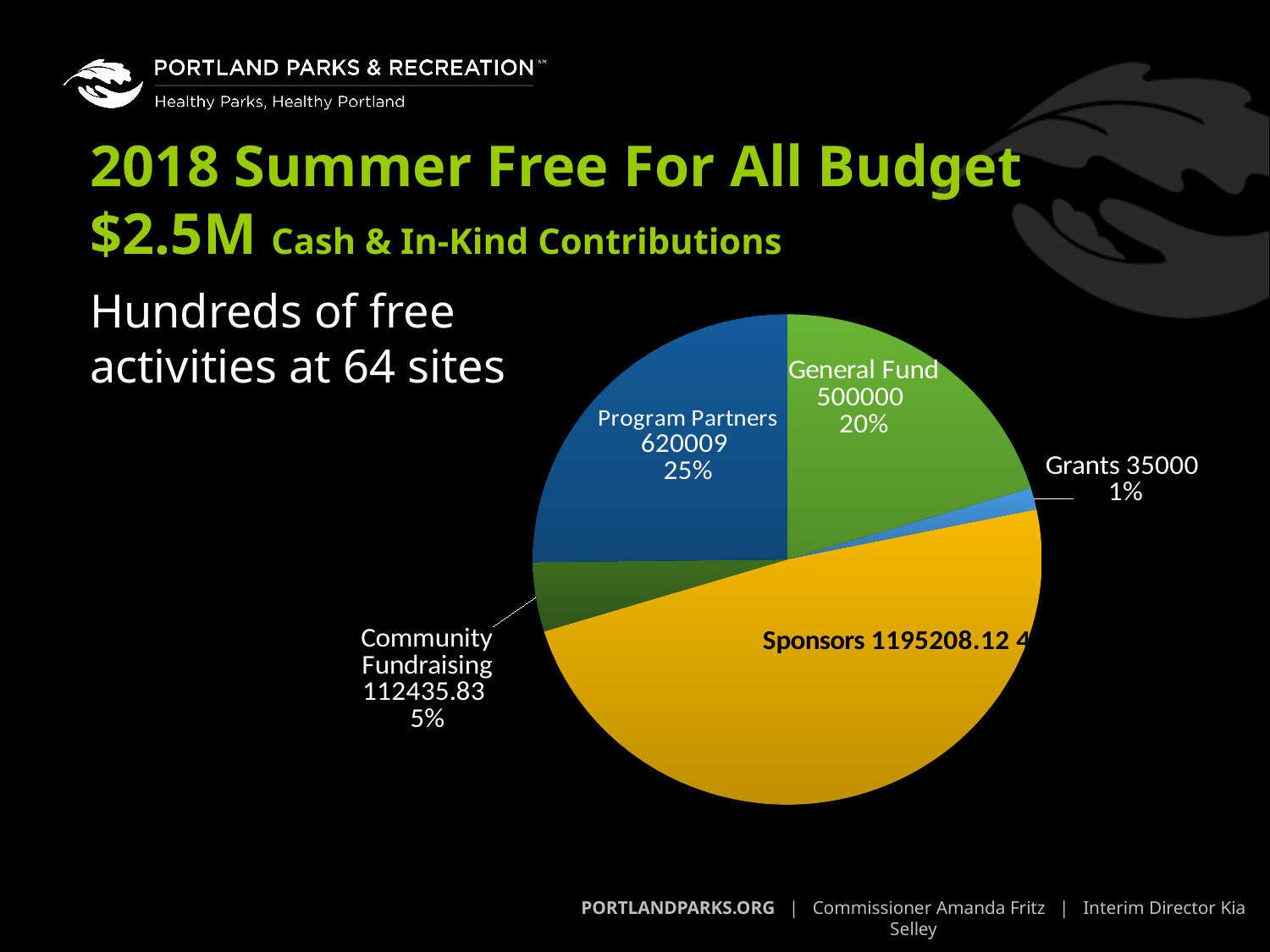
What value is shown for General Fund in the pie chart? 500000 How many categories are shown in the pie chart? 5 What share of the pie does Grants represent? 1% Which is larger, Program Partners or General Fund? Program Partners What value is shown for Sponsors in the pie chart? 1195208.12 What value is shown for Program Partners in the pie chart? 620009 What share of the pie does General Fund represent? 20% Which category has the largest slice of the pie chart? Sponsors Which category has the smallest slice of the pie chart? Grants What value is shown for Grants in the pie chart? 35000 What value is shown for Community Fundraising in the pie chart? 112435.83 What share of the pie does Program Partners represent? 25%